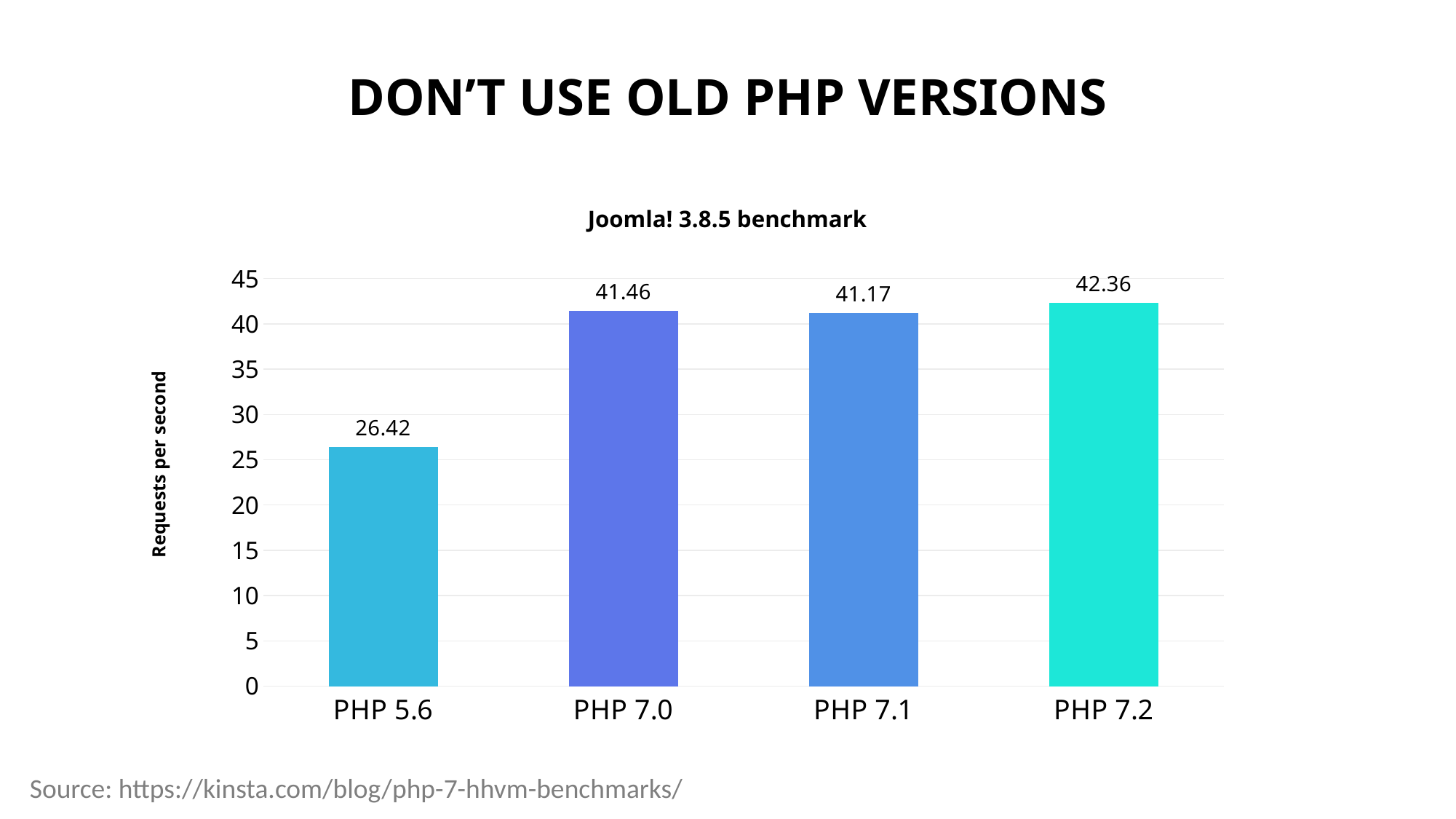
What is the requests per second value for PHP 5.6? 26.42 Is the value for PHP 5.6 greater or less than 30? less What kind of chart is shown on the slide? Bar chart How many PHP versions are shown in the chart? 4 What is the requests per second value for PHP 7.2? 42.36 Which PHP version has the highest requests per second? PHP 7.2 Which has more requests per second, PHP 7.0 or PHP 5.6? PHP 7.0 What is the requests per second value for PHP 7.0? 41.46 Which PHP version has the lowest requests per second? PHP 5.6 What is the title of the chart? Joomla! 3.8.5 benchmark What is the difference in requests per second between PHP 7.2 and PHP 5.6? 15.94 What is the difference in requests per second between PHP 7.0 and PHP 7.1? 0.29